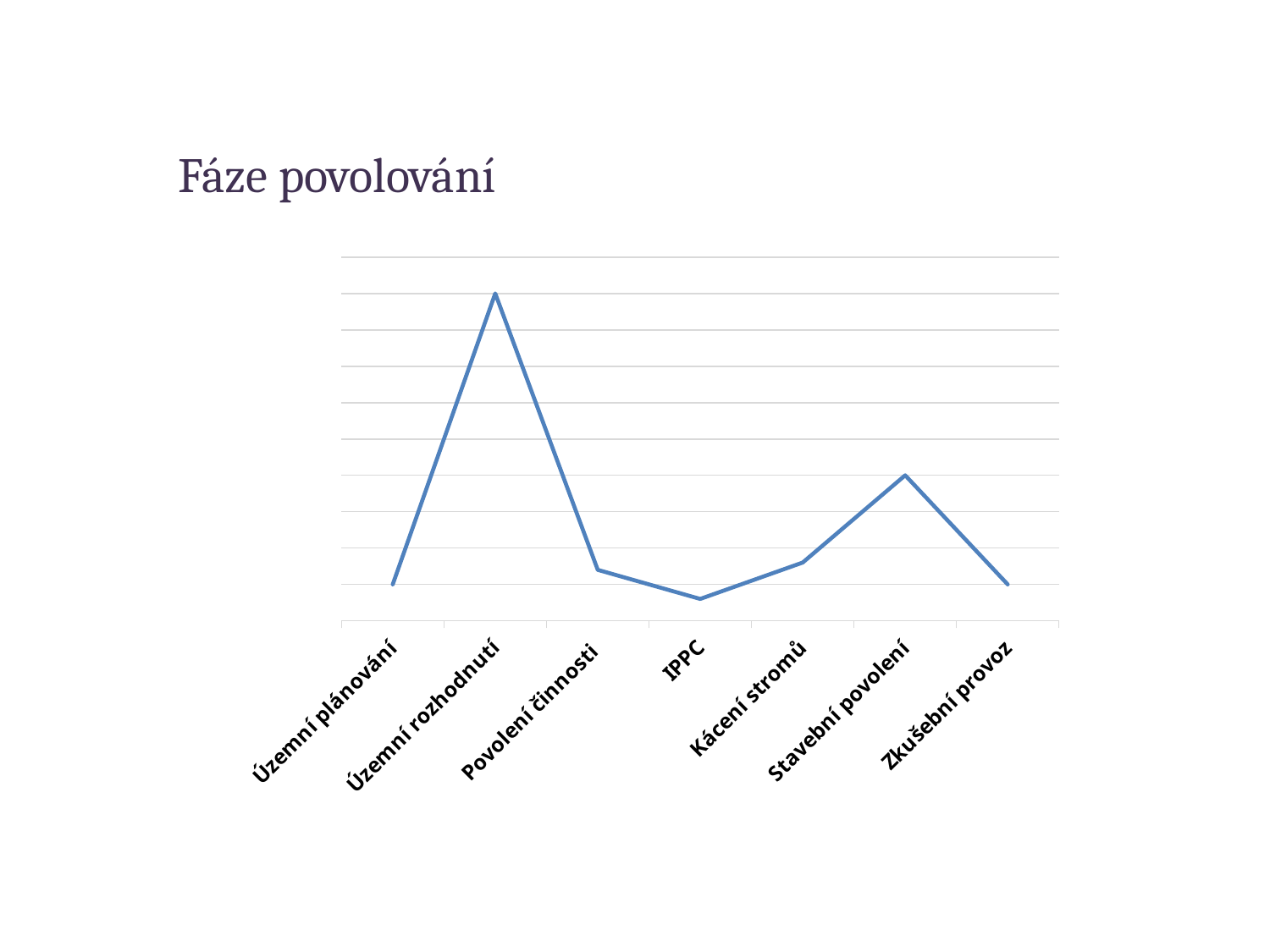
Which category has the lowest value in the chart? IPPC Which has the larger value, Stavební povolení or Zkušební provoz? Stavební povolení How many categories are plotted along the x axis of the chart? 7 What is the title of the slide containing the chart? Fáze povolování Which has the larger value, Územní rozhodnutí or Stavební povolení? Územní rozhodnutí What is the label of the first category on the x axis? Územní plánování Do the values rise or fall from IPPC to Stavební povolení? rise Do the values rise or fall from Územní rozhodnutí to IPPC? fall What kind of chart is shown on the slide? line chart Which has the larger value, Stavební povolení or Kácení stromů? Stavební povolení Which category has the highest value in the chart? Územní rozhodnutí